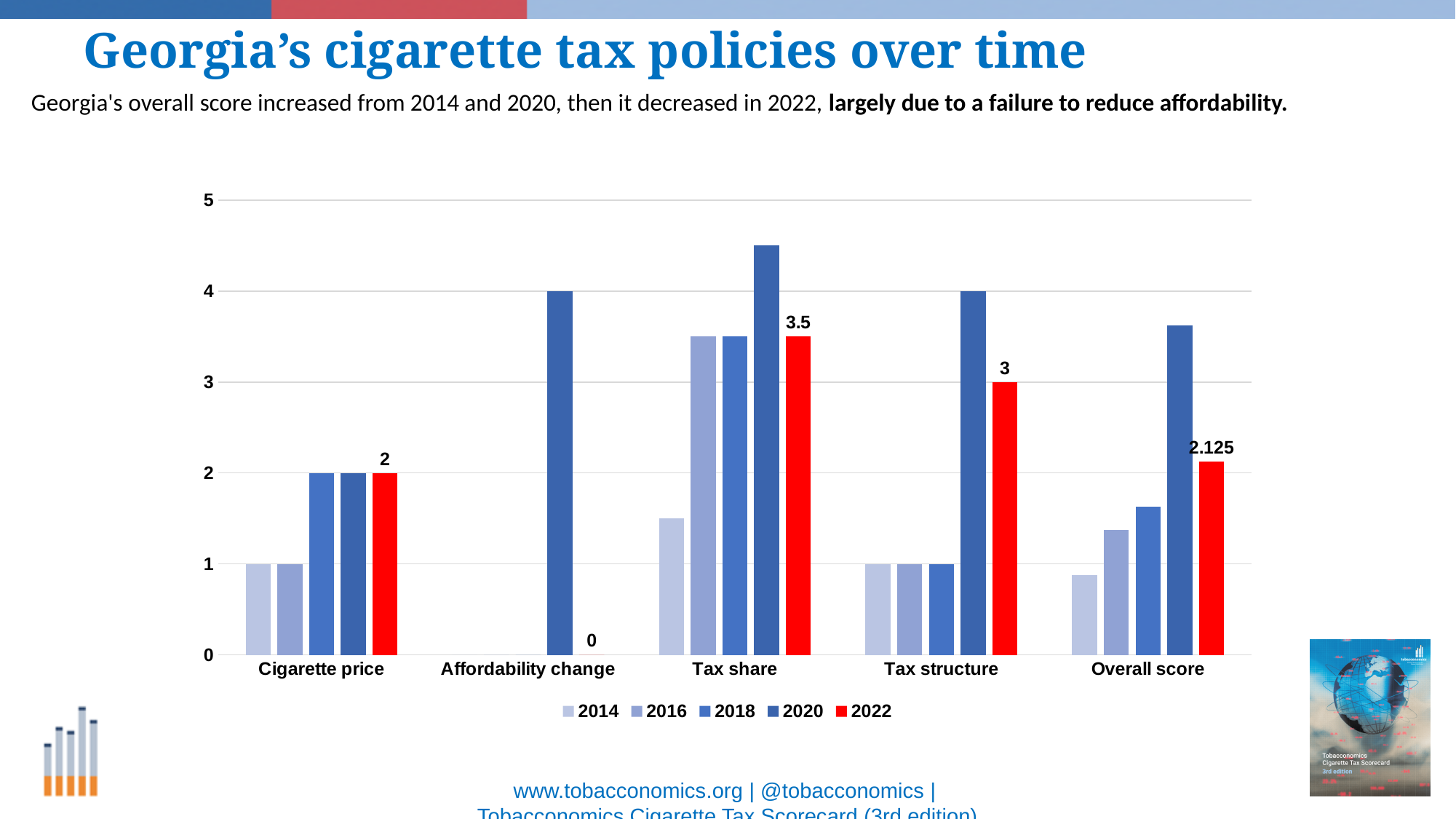
How many categories are shown on the x axis? 5 What is the 2022 value for Tax share? 3.5 What kind of chart is shown on the slide? bar chart Is the 2020 value for Overall score greater or less than 3? greater Which category has the lowest 2022 value? Affordability change How many series does the legend list? 5 Which category has the highest 2022 value? Tax share What is the 2020 value for Affordability change? 4 What is the 2022 value for Overall score? 2.125 What is the 2022 value for Affordability change? 0 What is the difference between the 2022 values for Tax share and Tax structure? 0.5 Which is larger in 2022: Tax structure or Overall score? Tax structure